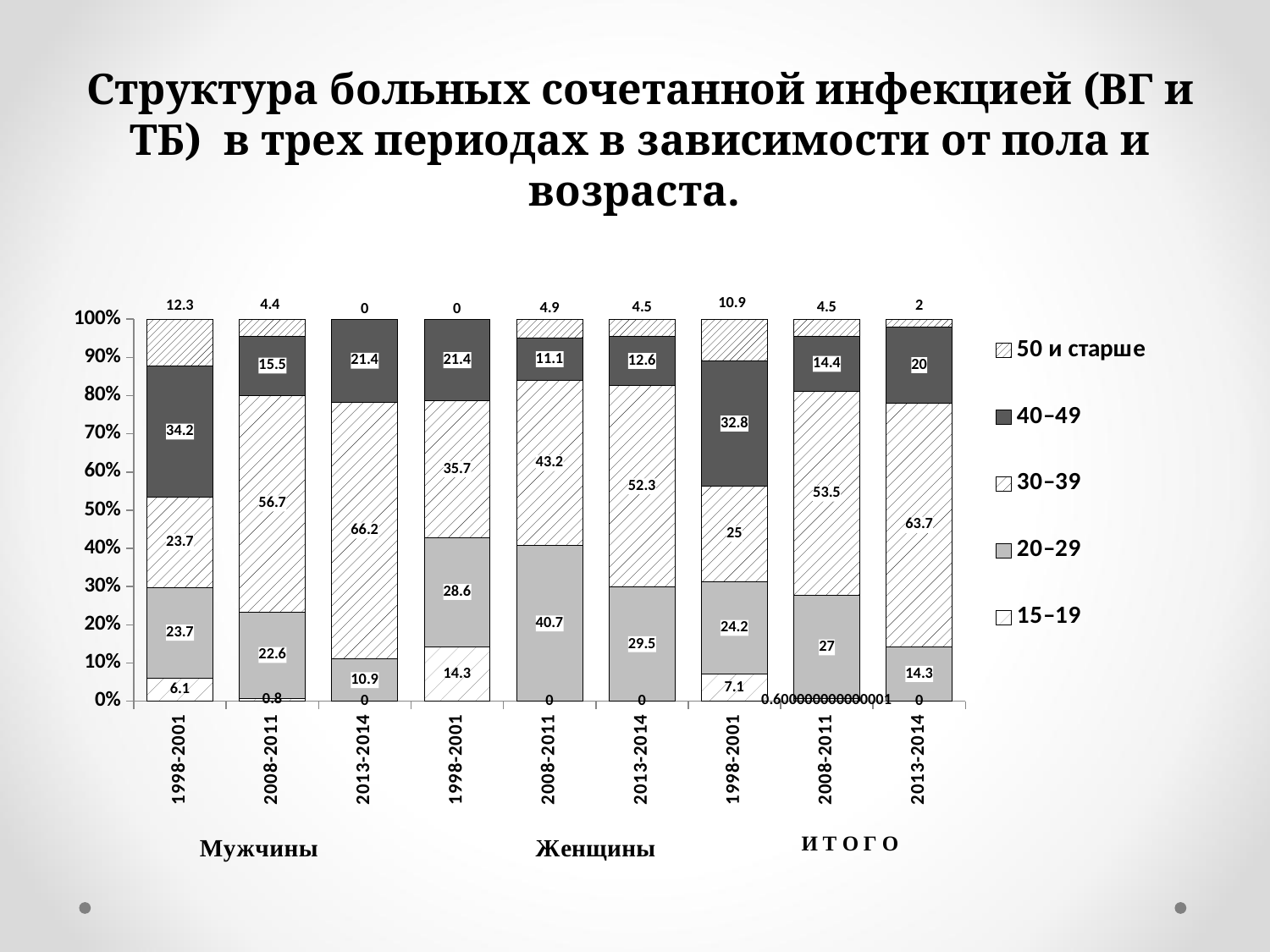
How many series does the legend list? 5 What is the value of the 50 и старше segment for И Т О Г О in 2013-2014? 2 How many bars are plotted in the chart? 9 What is the value of the 30–39 segment for Мужчины in 2013-2014? 66.2 What is the value of the 15–19 segment for Женщины in 1998-2001? 14.3 What is the difference between the 30–39 segment for И Т О Г О in 2013-2014 and in 1998-2001? 38.7 What kind of chart is shown on the slide? stacked bar chart Which legend entry is shown with a solid dark grey fill? 40–49 Which bar has the highest value for the 30–39 segment? Мужчины 2013-2014 Which is larger: the 40–49 segment for Мужчины in 1998-2001 or for Женщины in 1998-2001? Мужчины 1998-2001 What is the value of the 40–49 segment for Мужчины in 1998-2001? 34.2 What is the value of the 20–29 segment for Женщины in 2008-2011? 40.7